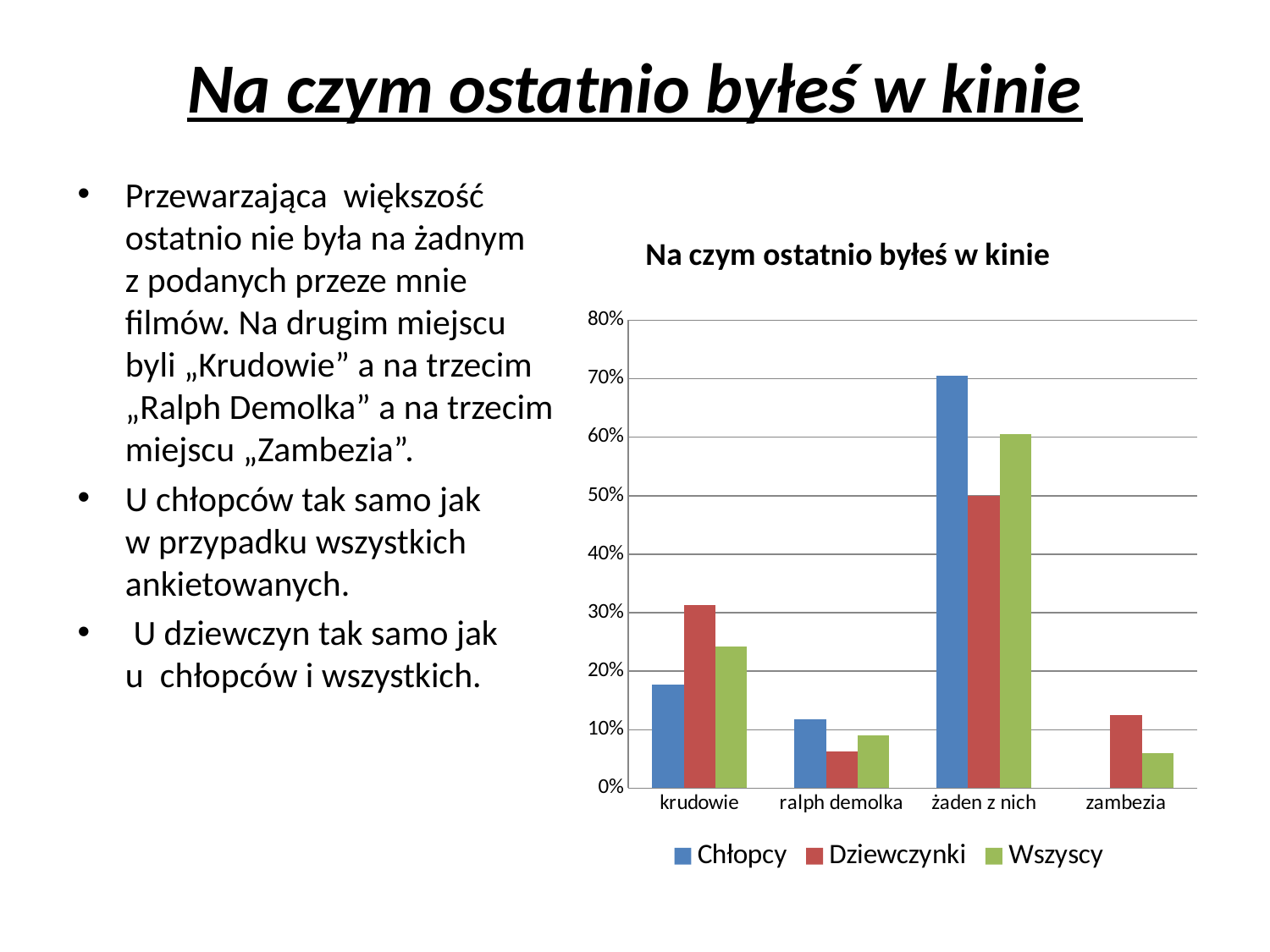
Is the Chłopcy value for krudowie greater or less than 20%? less Which category has the highest value for the Chłopcy series? żaden z nich What kind of chart is shown on the slide? bar chart For the category krudowie, which series has the larger value, Chłopcy or Dziewczynki? Dziewczynki Is the Dziewczynki value for zambezia greater or less than 10%? greater How many categories are shown on the x axis of the chart? 4 Which category has the lowest value for the Dziewczynki series? ralph demolka Which series is shown in green in the chart? Wszyscy Is the Chłopcy value for żaden z nich greater or less than 60%? greater How many series does the chart's legend list? 3 What is the title of the chart? Na czym ostatnio byłeś w kinie